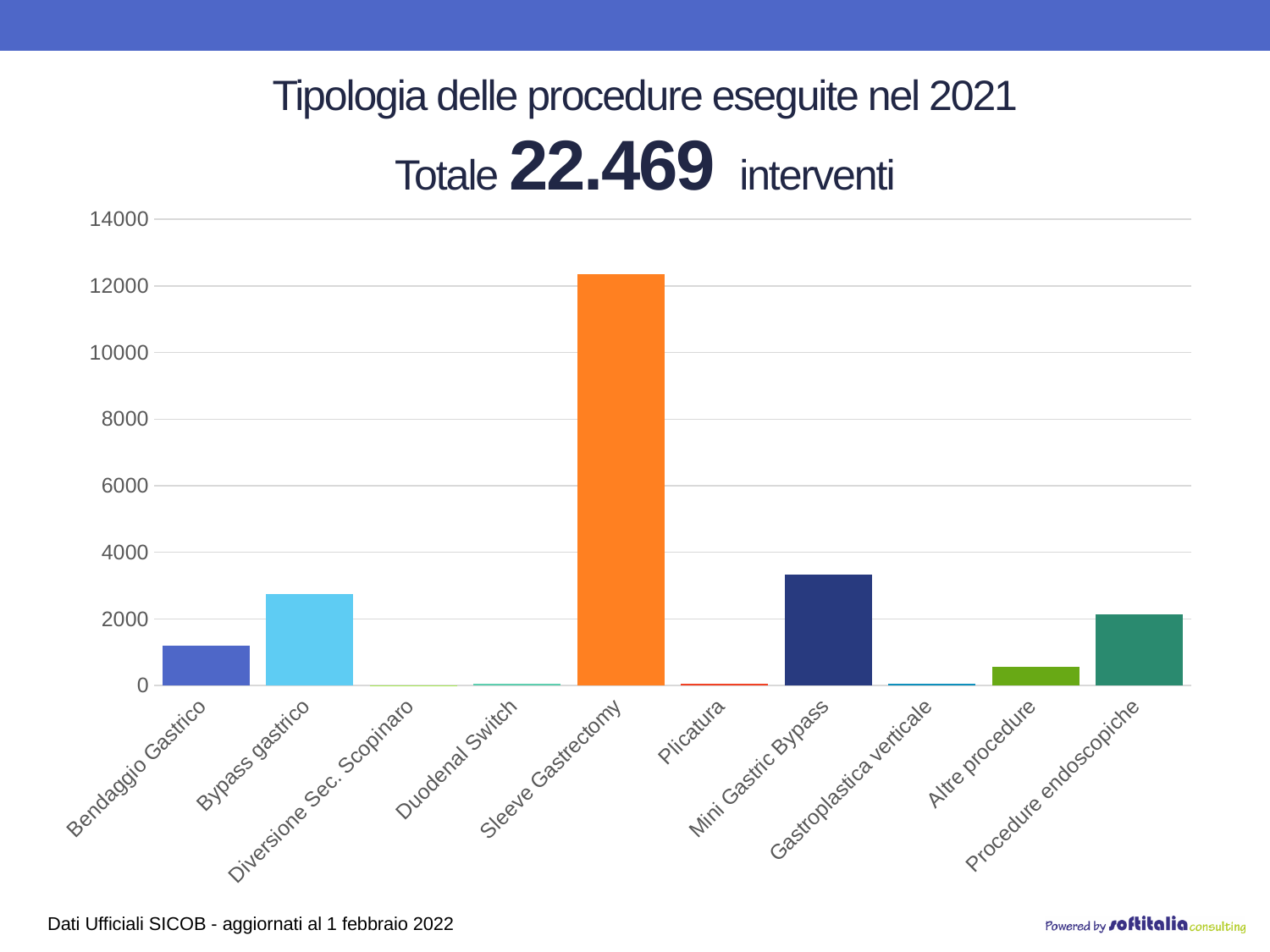
Which is larger, Mini Gastric Bypass or Bypass gastrico? Mini Gastric Bypass Is the value for Mini Gastric Bypass greater or less than 4000? less How many procedure categories are shown on the x axis? 10 Which is larger, Bendaggio Gastrico or Altre procedure? Bendaggio Gastrico Which procedure has the highest number of interventions? Sleeve Gastrectomy Is the value for Bypass gastrico greater or less than 2000? greater What total number of interventions is stated above the chart? 22.469 Is the value for Sleeve Gastrectomy greater or less than 12000? greater What kind of chart is shown on the slide? bar chart What is the title of the chart? Tipologia delle procedure eseguite nel 2021